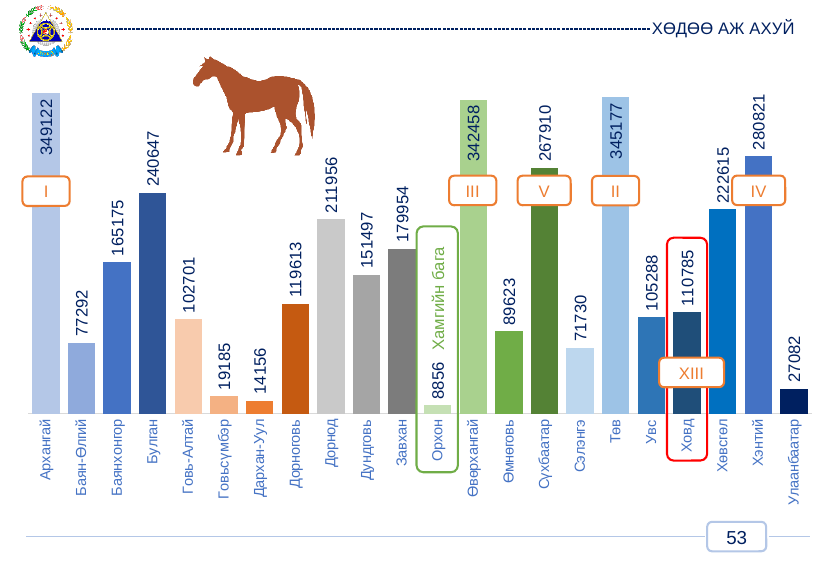
How many categories are shown on the x axis? 22 What is the value shown for Архангай? 349122 Which category has the highest value? Архангай What is the value shown for Улаанбаатар? 27082 What is the difference between the values for Хэнтий and Хөвсгөл? 58206 Which is larger, the value for Завхан or the value for Дундговь? Завхан What is the difference between the values for Булган and Дорнод? 28691 What is the value shown for Сүхбаатар? 267910 Which category has the lowest value? Орхон Which category is marked with the annotation "Хамгийн бага"? Орхон What is the value shown for Ховд? 110785 What kind of chart is shown on the slide? Bar chart